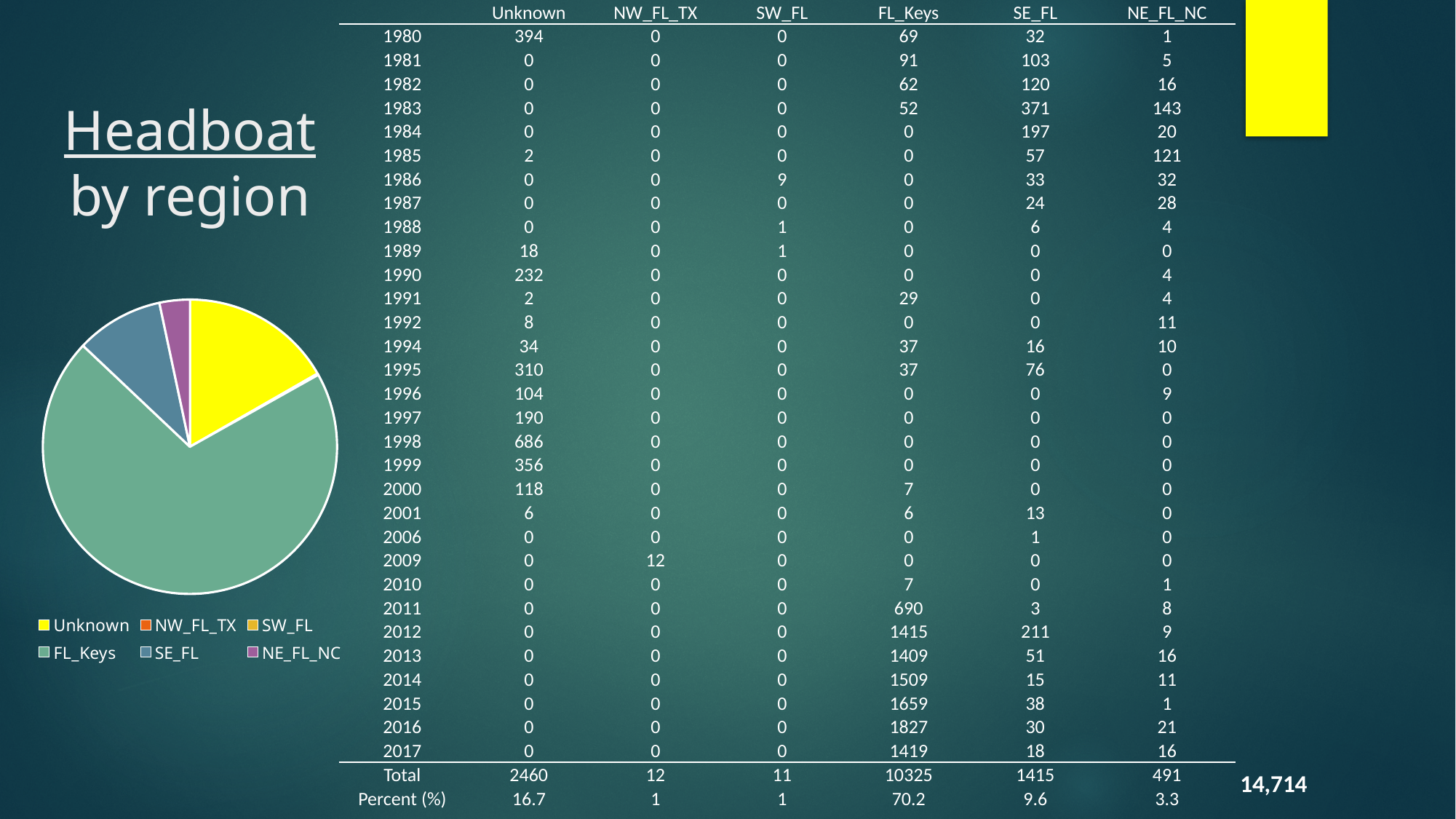
In the pie chart, which slice is larger, FL_Keys or Unknown? FL_Keys According to the Percent (%) row on the slide, what share of the pie does Unknown represent? 16.7 What is the overall total across all regions shown on the slide? 14,714 How many regions does the pie chart's legend list? 6 What kind of chart is shown on the slide? pie chart Which region has the largest slice of the pie chart? FL_Keys In the pie chart, which slice is larger, Unknown or SE_FL? Unknown According to the Percent (%) row on the slide, what share of the pie does FL_Keys represent? 70.2 What colour is the Unknown slice in the pie chart? yellow In the pie chart, which slice is larger, SE_FL or NE_FL_NC? SE_FL According to the Percent (%) row on the slide, what share of the pie does SE_FL represent? 9.6 What colour is the FL_Keys slice in the pie chart? green